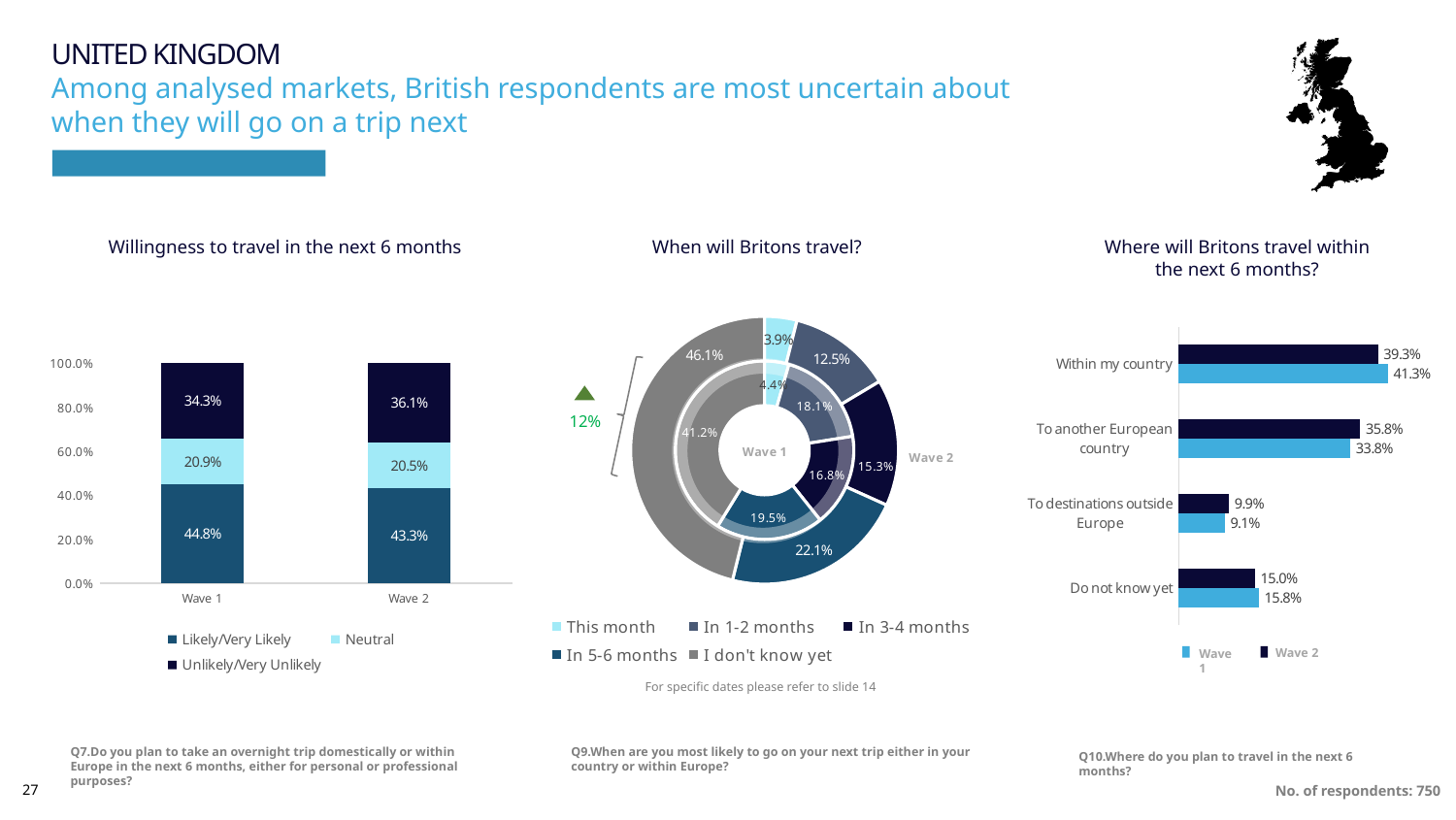
In the 'When will Britons travel?' chart, what is the Wave 1 share for 'In 5-6 months'? 19.5% How many categories does the legend of the 'When will Britons travel?' chart list? 5 In the 'Where will Britons travel within the next 6 months?' chart, what is the Wave 1 value for 'Within my country'? 41.3% In the 'Willingness to travel in the next 6 months' chart, what is the Likely/Very Likely value for Wave 1? 44.8% In the 'Where will Britons travel within the next 6 months?' chart, is the Wave 2 value for 'To another European country' larger or smaller than the Wave 1 value? Larger In the 'Willingness to travel in the next 6 months' chart, what is the Unlikely/Very Unlikely value for Wave 2? 36.1% In the 'When will Britons travel?' chart, what is the Wave 2 share for 'I don't know yet'? 46.1% In the 'When will Britons travel?' chart, which category has the smallest Wave 2 share? This month In the 'Where will Britons travel within the next 6 months?' chart, which category has the lowest Wave 2 value? To destinations outside Europe How many series does the legend of the 'Willingness to travel in the next 6 months' chart list? 3 In the 'Willingness to travel in the next 6 months' chart, what is the difference between the Neutral values for Wave 1 and Wave 2? 0.4% What kind of chart is 'Willingness to travel in the next 6 months'? Stacked bar chart